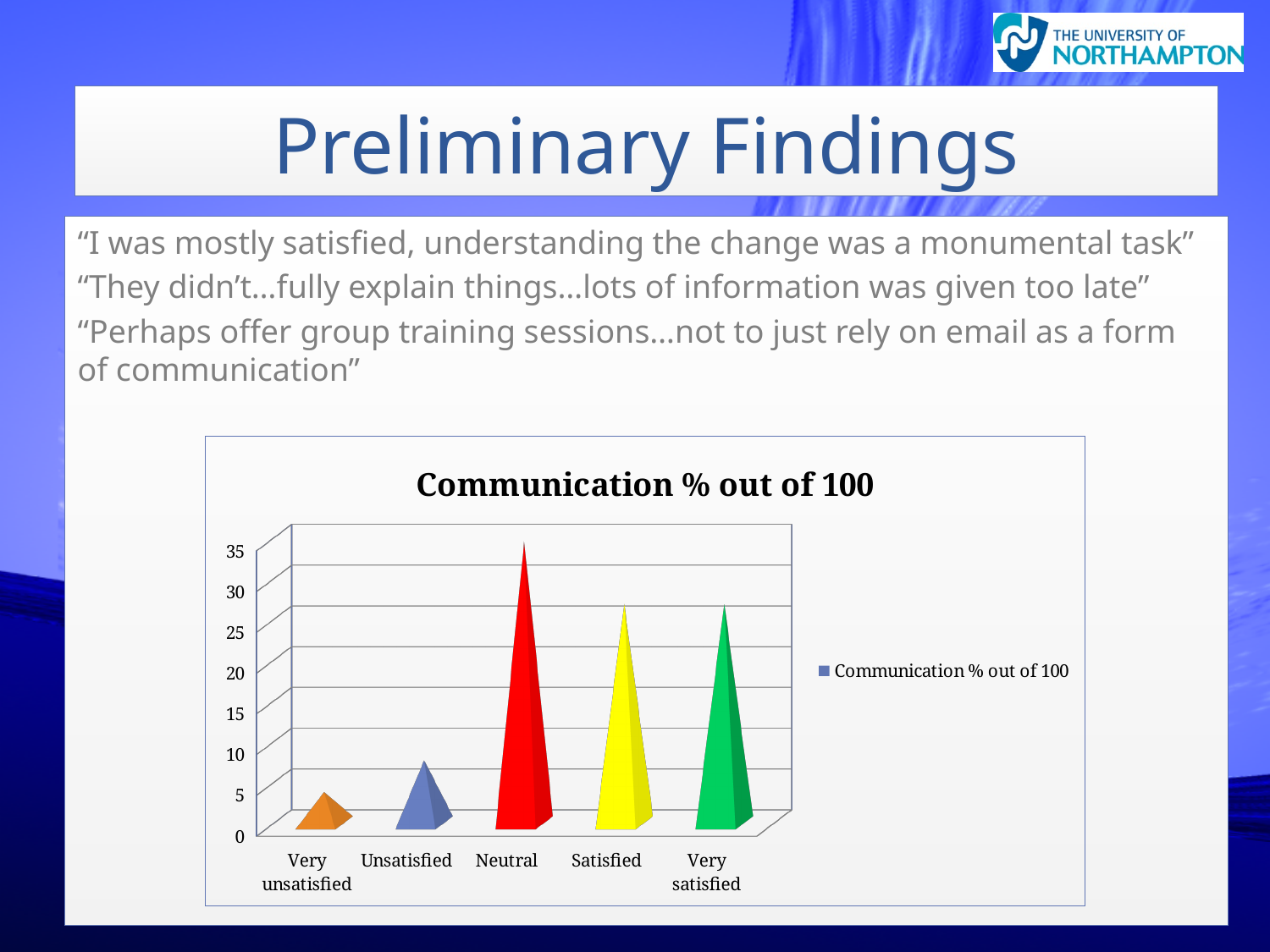
Which category has the highest value in the chart? Neutral Is the value for Neutral greater or less than 30? greater Is the value for Satisfied greater or less than 20? greater What kind of chart is shown on the slide? bar chart Which is larger, the value for Neutral or the value for Satisfied? Neutral Which is larger, the value for Unsatisfied or the value for Very unsatisfied? Unsatisfied What is the title of the chart? Communication % out of 100 Is the value for Very unsatisfied greater or less than 5? less How many series does the chart's legend list? 1 How many categories are shown on the x axis of the chart? 5 Which category has the lowest value in the chart? Very unsatisfied